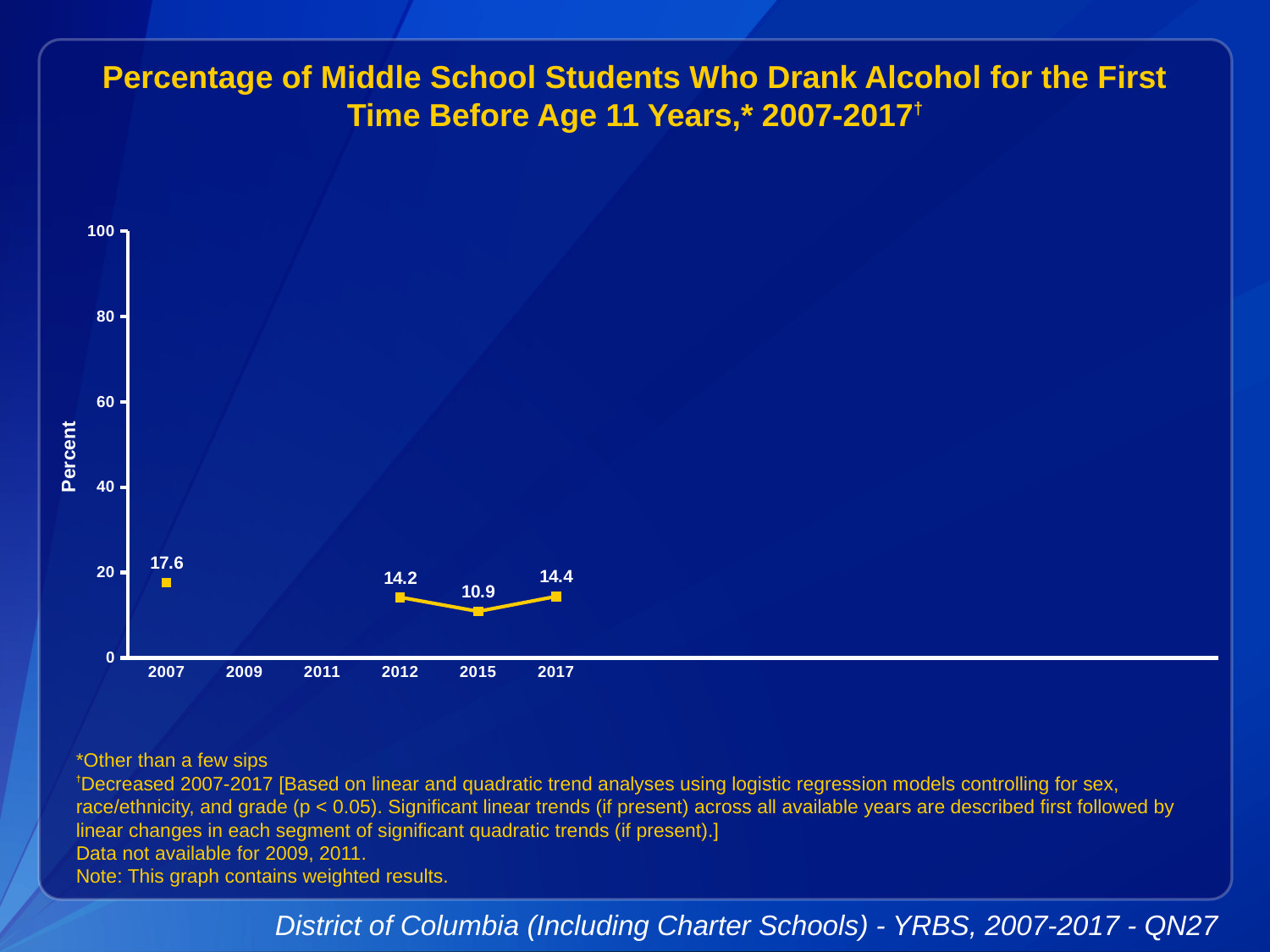
What is the value for 2007? 17.6 Which year has the highest value? 2007 What is the value for 2017? 14.4 What is the difference between the values for 2007 and 2017? 3.2 Is the value for 2007 greater or less than 20? less What is the value for 2015? 10.9 Which is larger, the value for 2012 or the value for 2015? 2012 How many years have data points plotted on the chart? 4 What kind of chart is shown on the slide? line chart What is the label on the y axis? Percent What is the value for 2012? 14.2 Which year has the lowest value? 2015